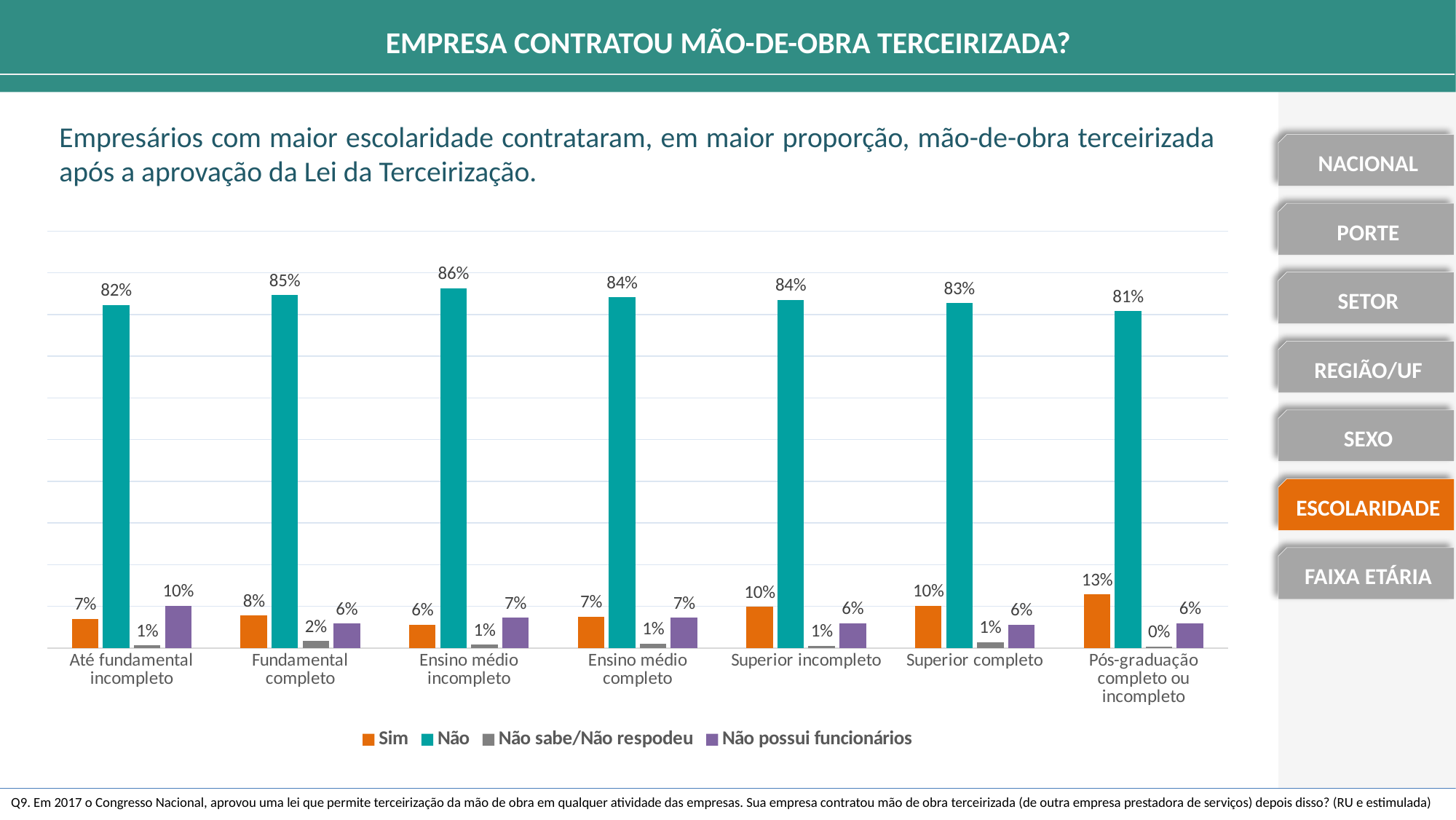
What is the value of the "Não" series for "Ensino médio incompleto"? 86% What is the value of "Não possui funcionários" for "Até fundamental incompleto"? 10% What kind of chart is shown on the slide? Bar chart Which category has the lowest value for the "Não" series? Pós-graduação completo ou incompleto Which category has the highest value for the "Sim" series? Pós-graduação completo ou incompleto How many education categories are shown on the x axis? 7 Which is larger: the "Sim" value for "Superior completo" or the "Sim" value for "Fundamental completo"? Superior completo What is the value of "Não sabe/Não respodeu" for "Fundamental completo"? 2% What is the value of the "Sim" series for "Pós-graduação completo ou incompleto"? 13% Which category has the highest value for the "Não" series? Ensino médio incompleto What is the difference between the "Sim" values for "Pós-graduação completo ou incompleto" and "Ensino médio incompleto"? 7% How many series does the legend list? 4